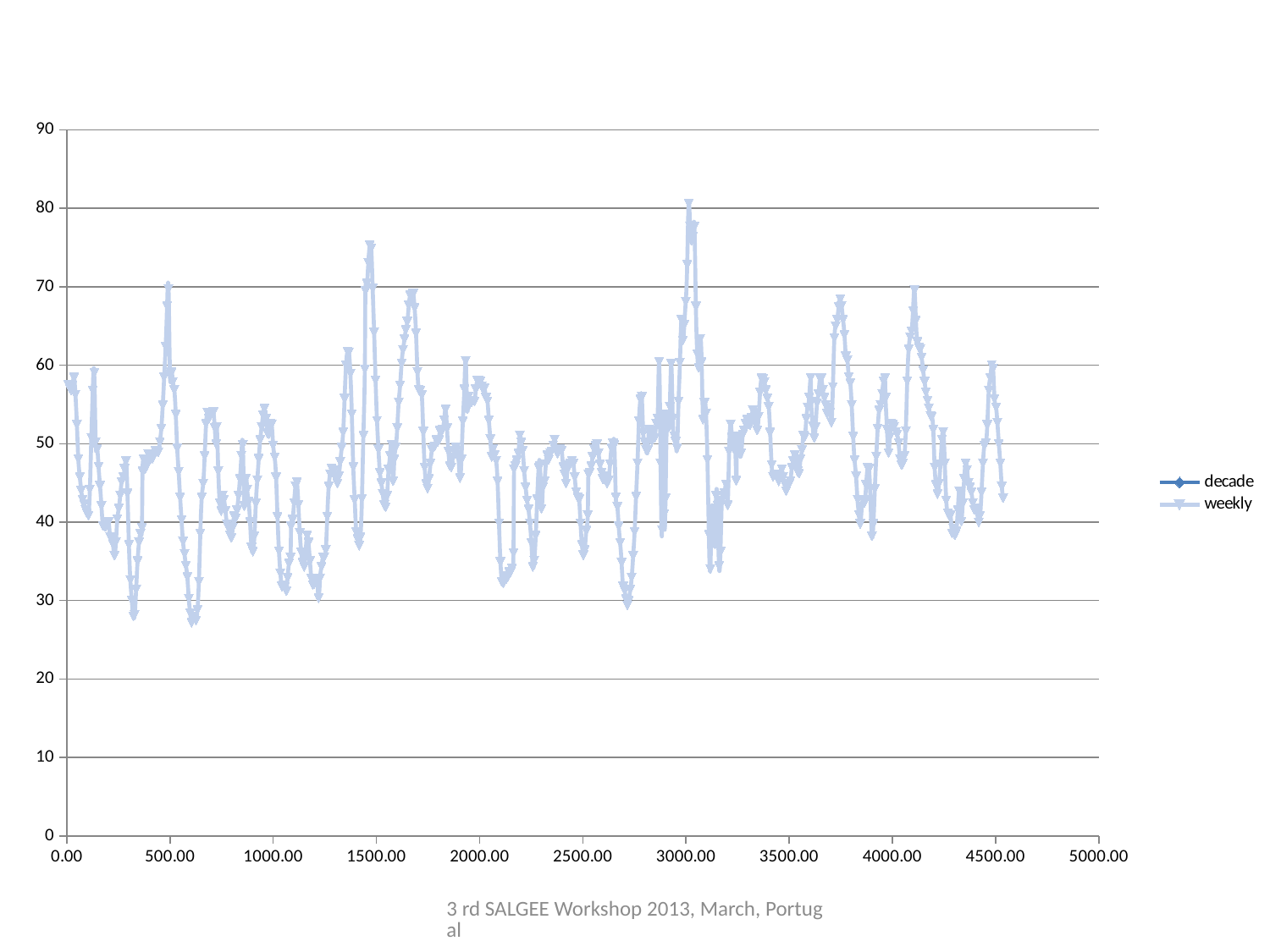
Is the highest peak of the weekly series, near x = 3000, greater or less than 70? greater Is the dip of the weekly series near x = 2700 greater or less than 40? less Which is higher: the peak of the weekly series near x = 3000 or the peak near x = 500? the peak near x = 3000 Is the lowest point of the weekly series near x = 300 greater or less than 30? less What are the two series names shown in the legend? decade and weekly How many series does the legend list? 2 What is the highest value shown on the vertical axis? 90 What kind of chart is shown on the slide? line chart